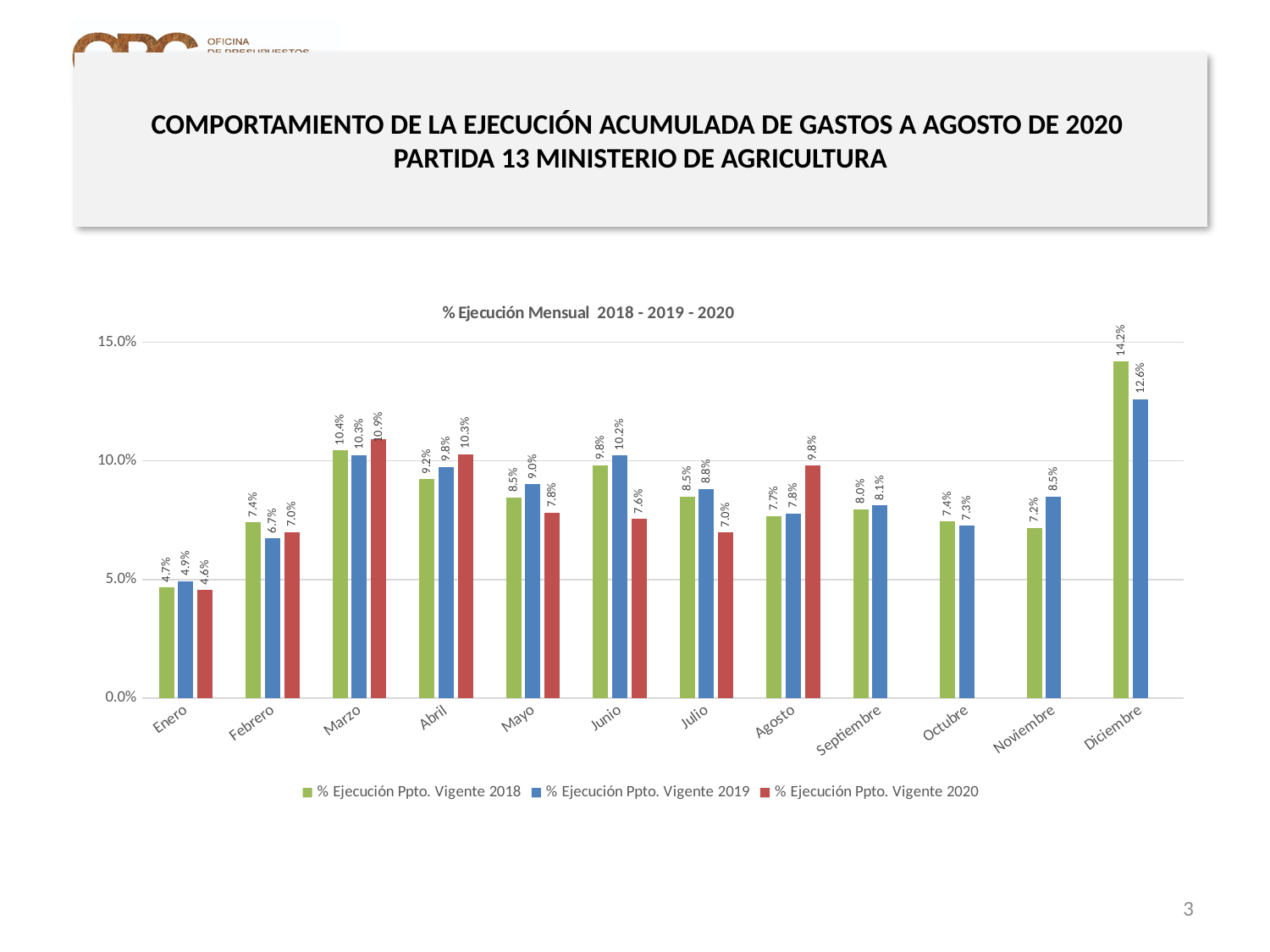
What kind of chart is shown? Bar chart What is the value for % Ejecución Ppto. Vigente 2019 in Junio? 10.2% What is the value for % Ejecución Ppto. Vigente 2018 in Diciembre? 14.2% What is the difference between the 2018 and 2019 values in Diciembre? 1.6% Which month has the lowest value for % Ejecución Ppto. Vigente 2020? Enero What is the title of the chart? % Ejecución Mensual 2018 - 2019 - 2020 What is the value for % Ejecución Ppto. Vigente 2020 in Marzo? 10.9% How many months are shown on the x axis? 12 How many series does the legend list? 3 Is the value for % Ejecución Ppto. Vigente 2018 in Marzo greater or less than 10.0%? greater In Agosto, which series has the larger value: % Ejecución Ppto. Vigente 2020 or % Ejecución Ppto. Vigente 2018? % Ejecución Ppto. Vigente 2020 Which month has the highest value for % Ejecución Ppto. Vigente 2019? Diciembre